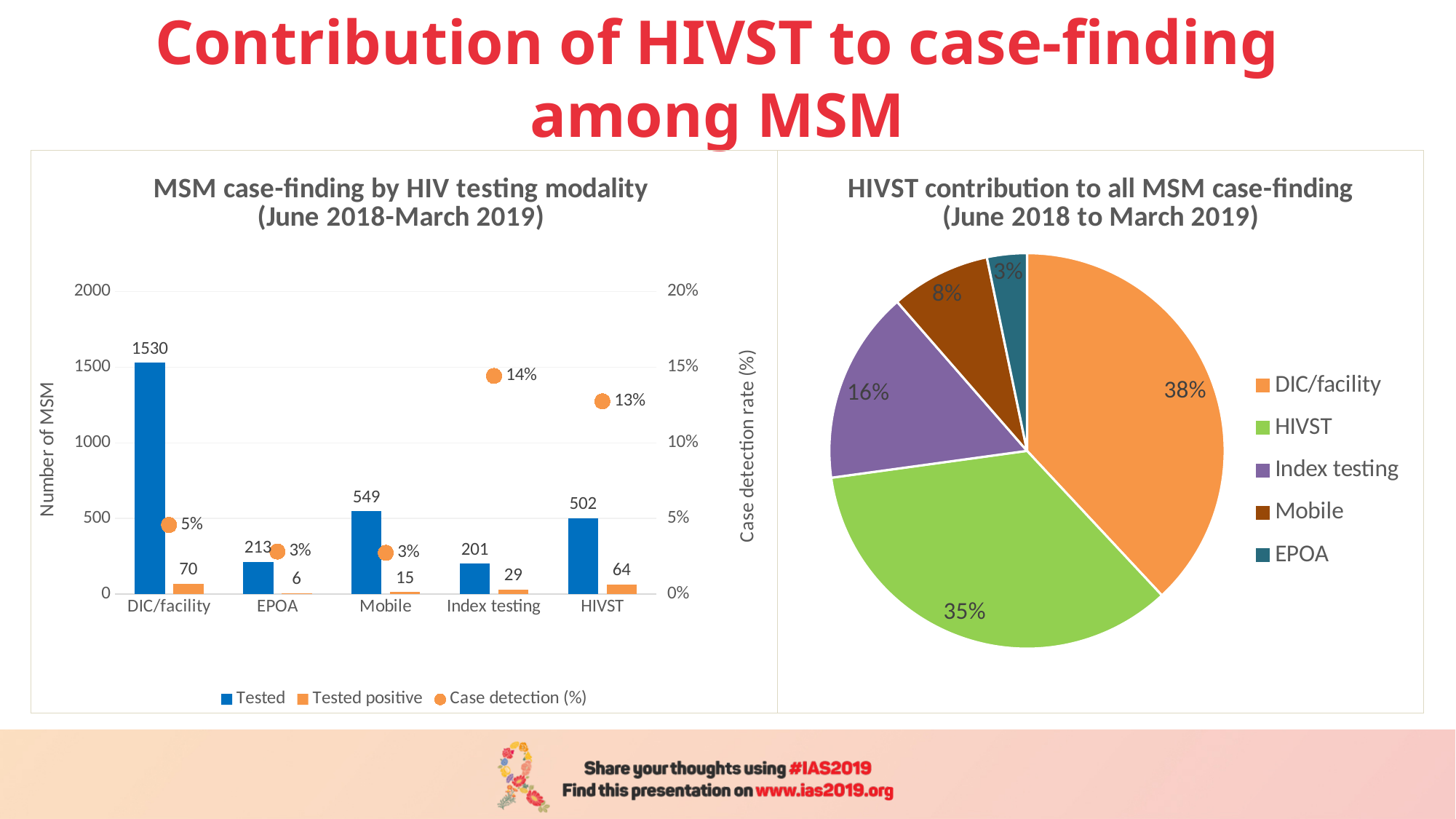
In the 'MSM case-finding by HIV testing modality' chart, how many testing modalities are shown on the x axis? 5 In the 'HIVST contribution to all MSM case-finding' chart, what share of case-finding is from HIVST? 35% In the 'MSM case-finding by HIV testing modality' chart, which modality has the highest number tested? DIC/facility In the 'MSM case-finding by HIV testing modality' chart, which has more MSM tested positive, DIC/facility or Index testing? DIC/facility In the 'MSM case-finding by HIV testing modality' chart, how many MSM were tested at DIC/facility? 1530 In the 'MSM case-finding by HIV testing modality' chart, what is the difference between the number tested at Mobile and at HIVST? 47 In the 'MSM case-finding by HIV testing modality' chart, how many MSM tested positive through HIVST? 64 What type of chart is the 'HIVST contribution to all MSM case-finding' chart? Pie chart In the 'MSM case-finding by HIV testing modality' chart, how many series does the legend list? 3 In the 'MSM case-finding by HIV testing modality' chart, what is the case detection rate for Index testing? 14% In the 'HIVST contribution to all MSM case-finding' chart, which category has the smallest slice? EPOA In the 'MSM case-finding by HIV testing modality' chart, which modality has the lowest number tested positive? EPOA